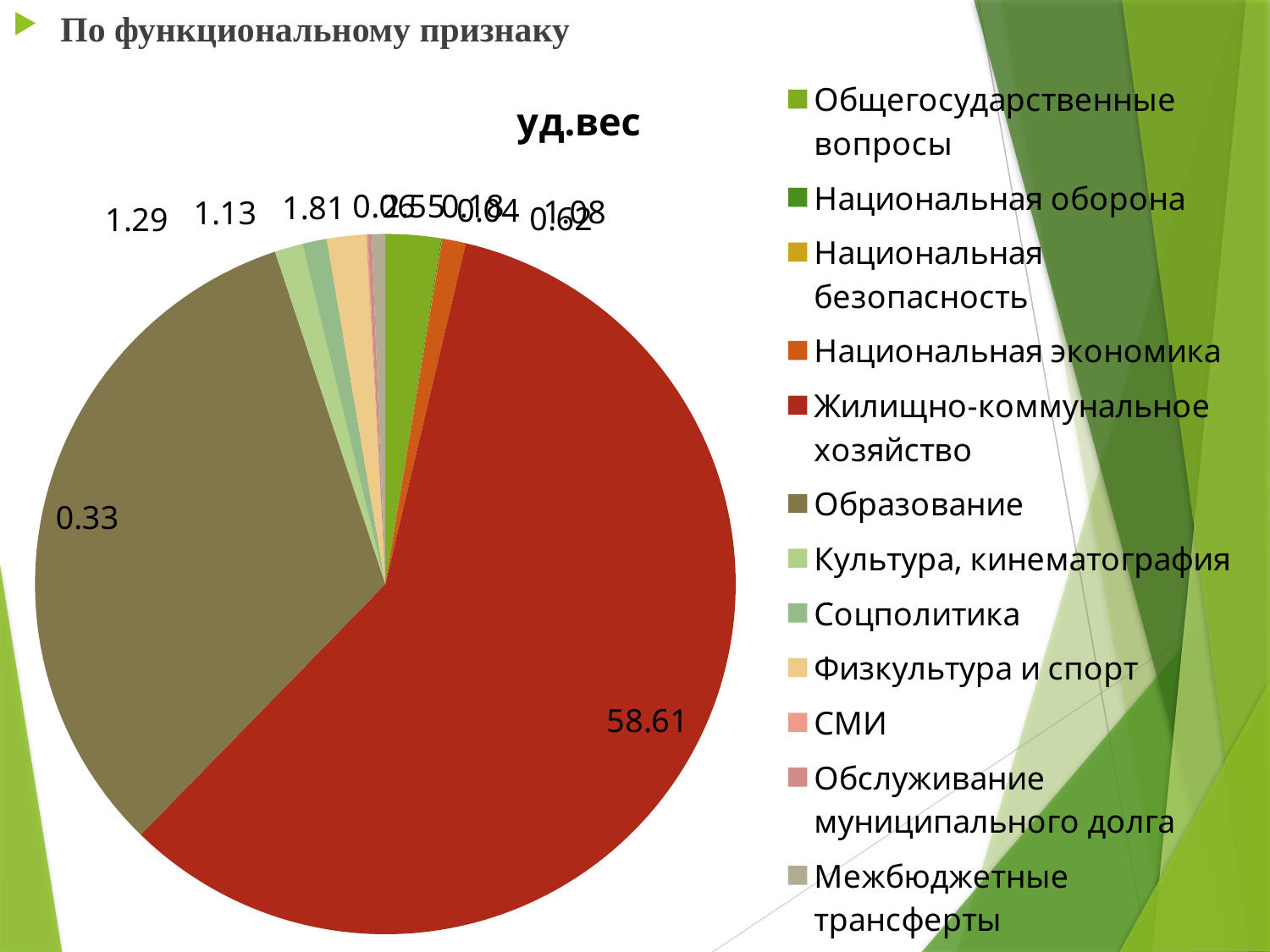
Which slice is larger, Образование or Общегосударственные вопросы? Образование What kind of chart is shown on the slide? pie chart Is the labelled value for Жилищно-коммунальное хозяйство greater or less than 50? greater What is the title of the chart? уд.вес What value is labelled on the slice for Жилищно-коммунальное хозяйство? 58.61 What value is labelled on the slice for Образование? 0.33 Which category has the largest slice in the pie chart? Жилищно-коммунальное хозяйство Which category has the second-largest slice in the pie chart? Образование How many categories does the legend of the pie chart list? 12 Which slice is larger, Жилищно-коммунальное хозяйство or Образование? Жилищно-коммунальное хозяйство What colour is the slice for Жилищно-коммунальное хозяйство? red